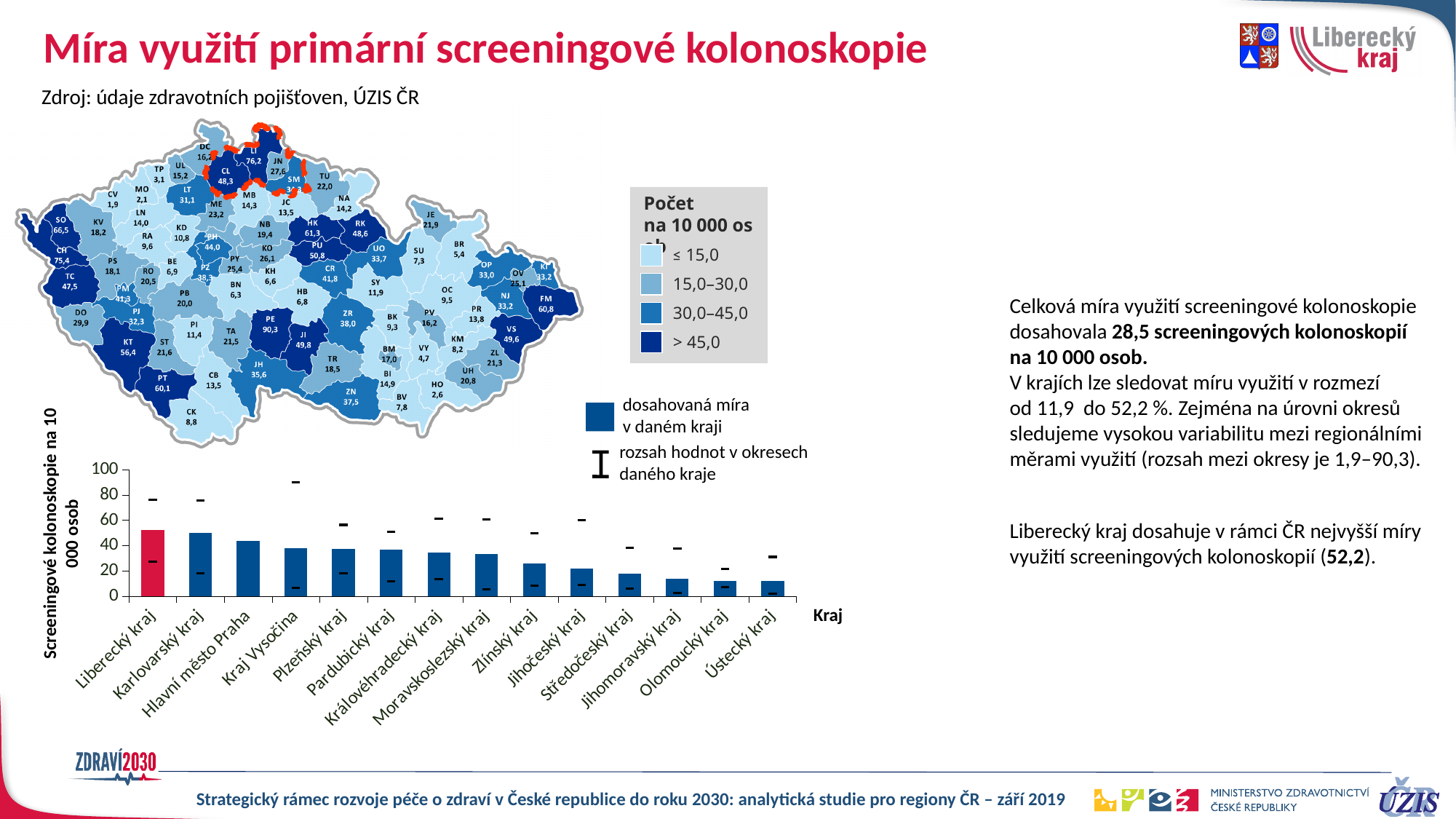
According to the slide, what rate of screening colonoscopies per 10 000 persons does Liberecký kraj reach? 52,2 On the map, what value is shown for district PE? 90,3 In the bar chart, which region has the lowest rate of screening colonoscopies? Ústecký kraj In the bar chart, which is larger: the value for Karlovarský kraj or for Hlavní město Praha? Karlovarský kraj On the map, which district has the lowest value? CV (1,9) In the bar chart, how many regions (kraje) are shown on the x axis? 14 In the bar chart, what colour is the bar for Liberecký kraj? red In the bar chart, is the value for Středočeský kraj greater or less than 20? less In the bar chart, do the values rise or fall from left to right along the x axis? fall In the bar chart, which region has the highest rate of screening colonoscopies? Liberecký kraj In the bar chart, is the value for Hlavní město Praha greater or less than 40? greater What kind of chart is shown at the bottom left of the slide? bar chart